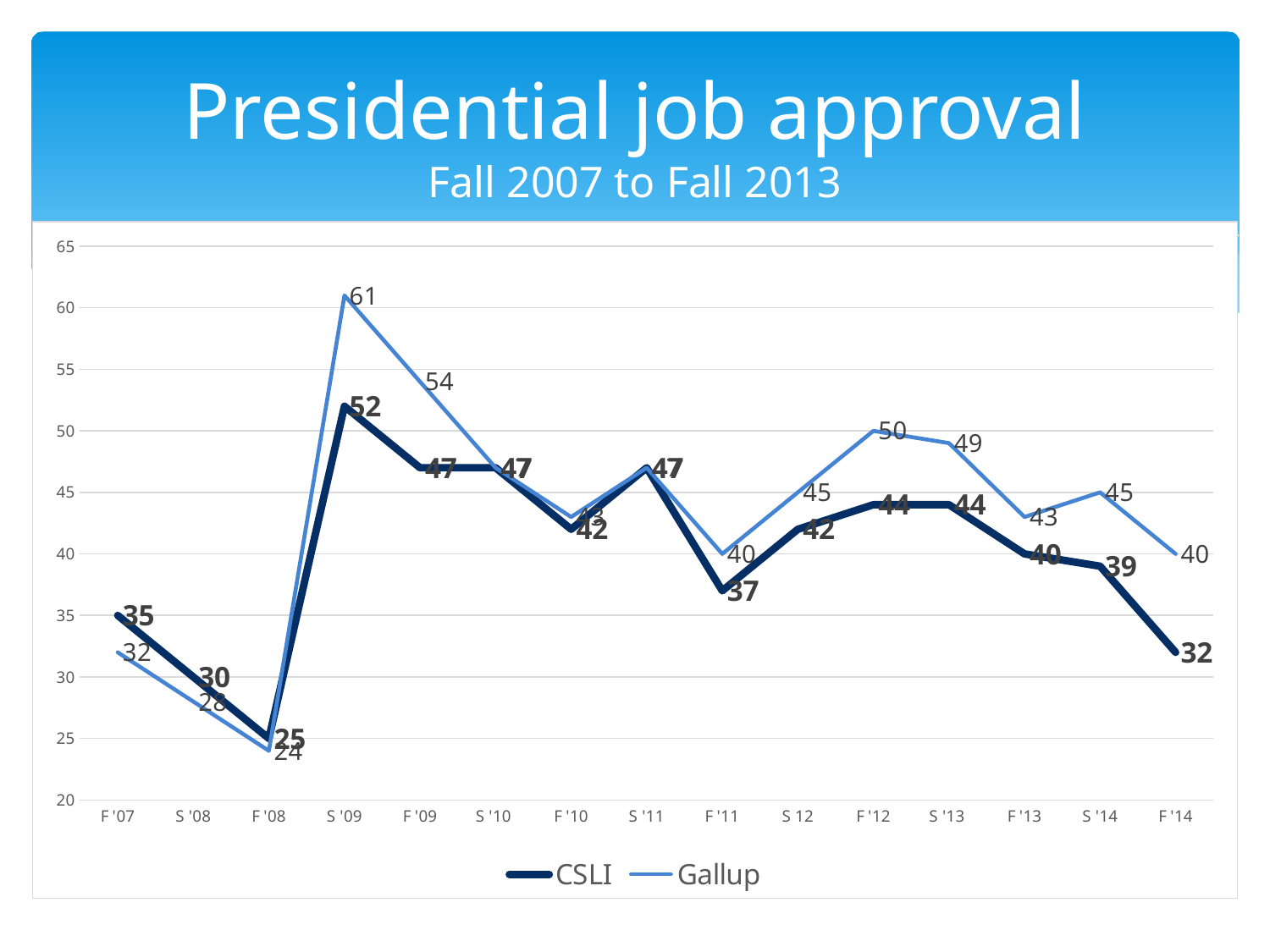
What is the Gallup value at S '09? 61 At which time point does the Gallup series reach its highest value? S '09 What are the two series named in the legend? CSLI and Gallup How many time points are plotted along the x axis? 15 Does the CSLI series rise or fall from F '12 to F '14? fall At F '14, which series has the higher value, CSLI or Gallup? Gallup At which time point is the CSLI series at its lowest value? F '08 What kind of chart is shown on the slide? line chart How many series does the legend list? 2 What is the difference between the Gallup and CSLI values at S '09? 9 What is the CSLI value at F '14? 32 What is the CSLI value at S '09? 52